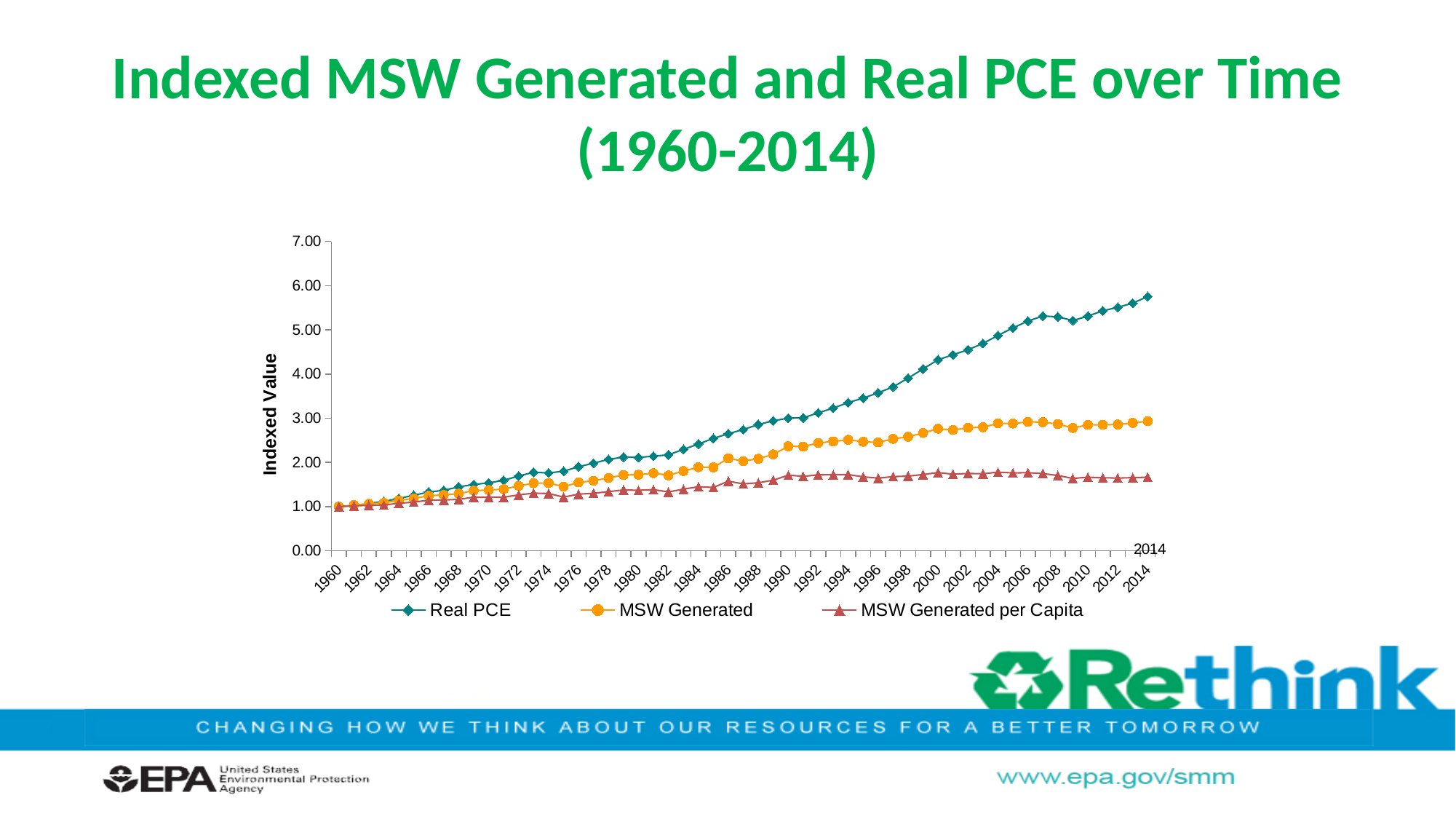
Is the value for Real PCE in 2014 greater or less than 5.00? greater Which series has the lowest value in 2014? MSW Generated per Capita Does the Real PCE series generally rise or fall from 1960 to 2014? rise How many series does the legend list? 3 What kind of chart is shown on the slide? Line chart Which is larger in 2000, MSW Generated or MSW Generated per Capita? MSW Generated What is the title of the chart on the slide? Indexed MSW Generated and Real PCE over Time (1960-2014) Is the value for Real PCE in 2000 greater or less than 3.00? greater Which series has the highest value in 2014? Real PCE What is the label on the vertical axis of the chart? Indexed Value How many year labels are shown along the x axis? 28 Is the value for MSW Generated per Capita in 2014 greater or less than 2.00? less